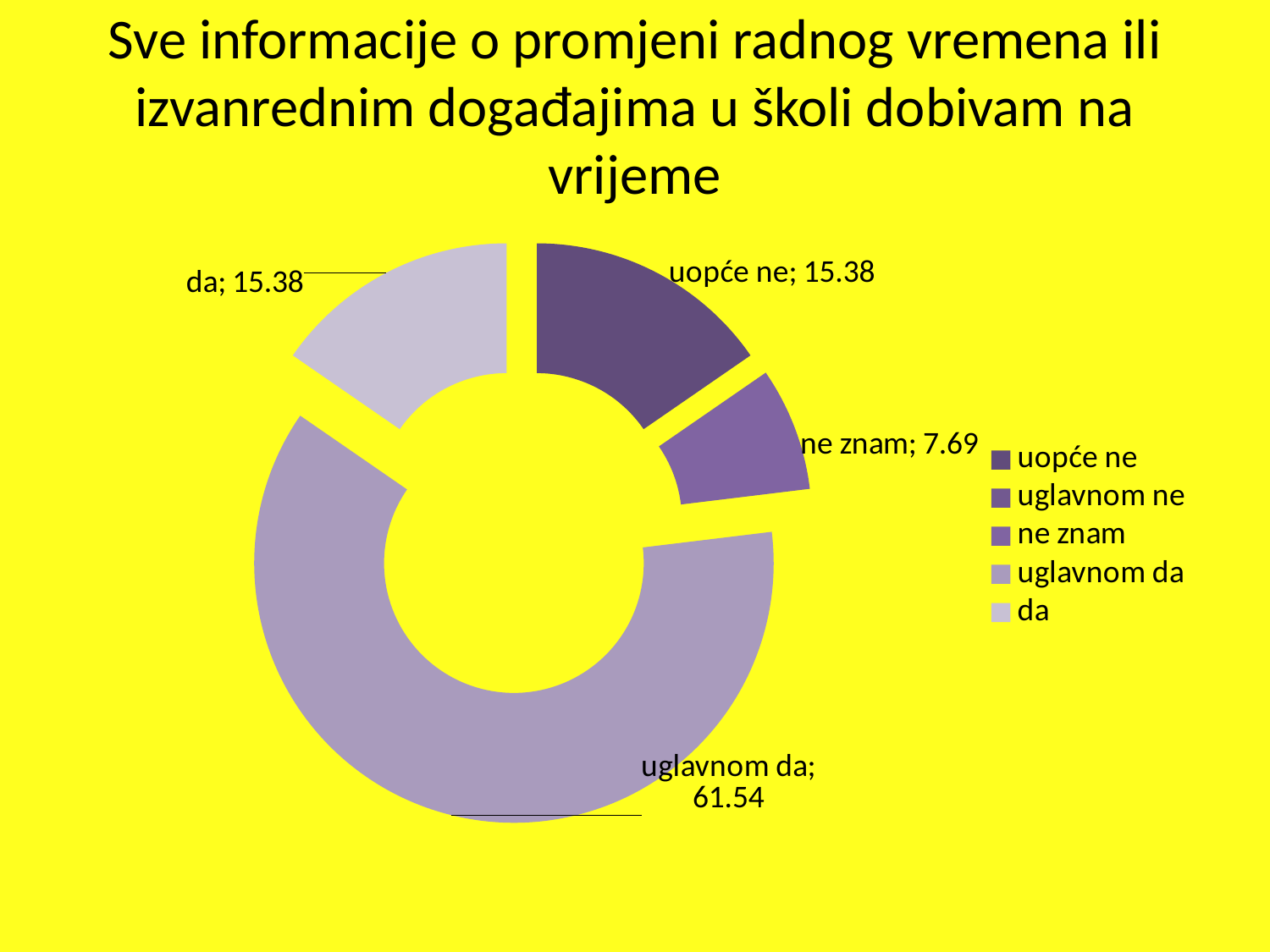
Which is larger, the value for "uglavnom da" or the value for "ne znam"? uglavnom da What is the difference between the values for "da" and "ne znam"? 7.69 How many entries does the legend list? 5 What value is shown for the "uglavnom da" slice? 61.54 Which labelled category has the smallest slice? ne znam What value is shown for the "da" slice? 15.38 Which category has the largest slice? uglavnom da What value is shown for the "uopće ne" slice? 15.38 How many slices with data labels are shown in the chart? 4 What value is shown for the "ne znam" slice? 7.69 What kind of chart is shown on the slide? doughnut (pie) chart What is the difference between the values for "uglavnom da" and "uopće ne"? 46.16